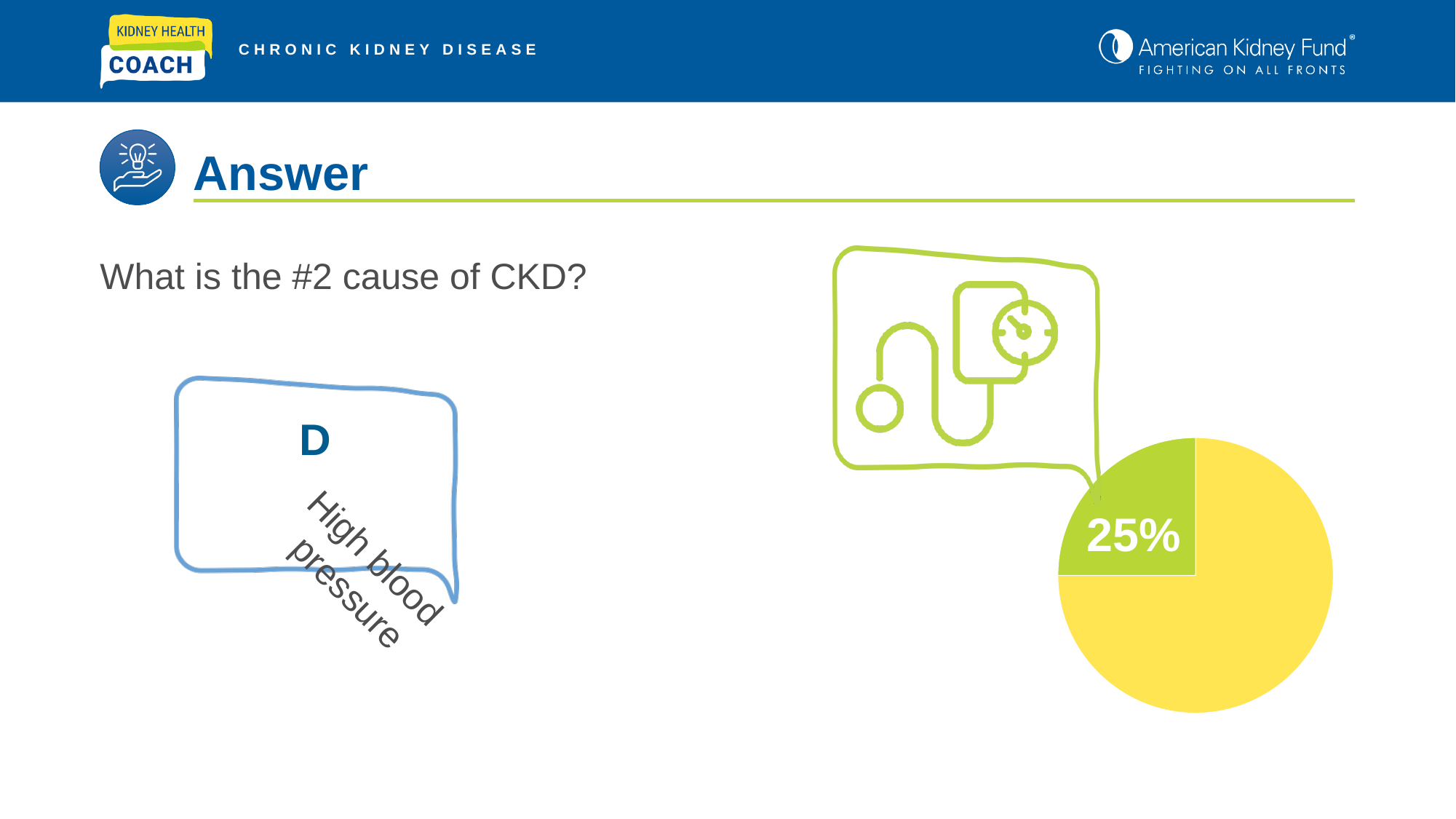
Which slice of the pie chart is smaller, the green slice or the yellow slice? green How many slices does the pie chart have? 2 What kind of chart is shown on the right side of the slide? pie chart What percentage is printed on the green slice of the pie chart? 25% What colour is the slice of the pie chart that carries the 25% label? green Does the pie chart have a legend? No Which slice of the pie chart is larger, the green slice or the yellow slice? yellow